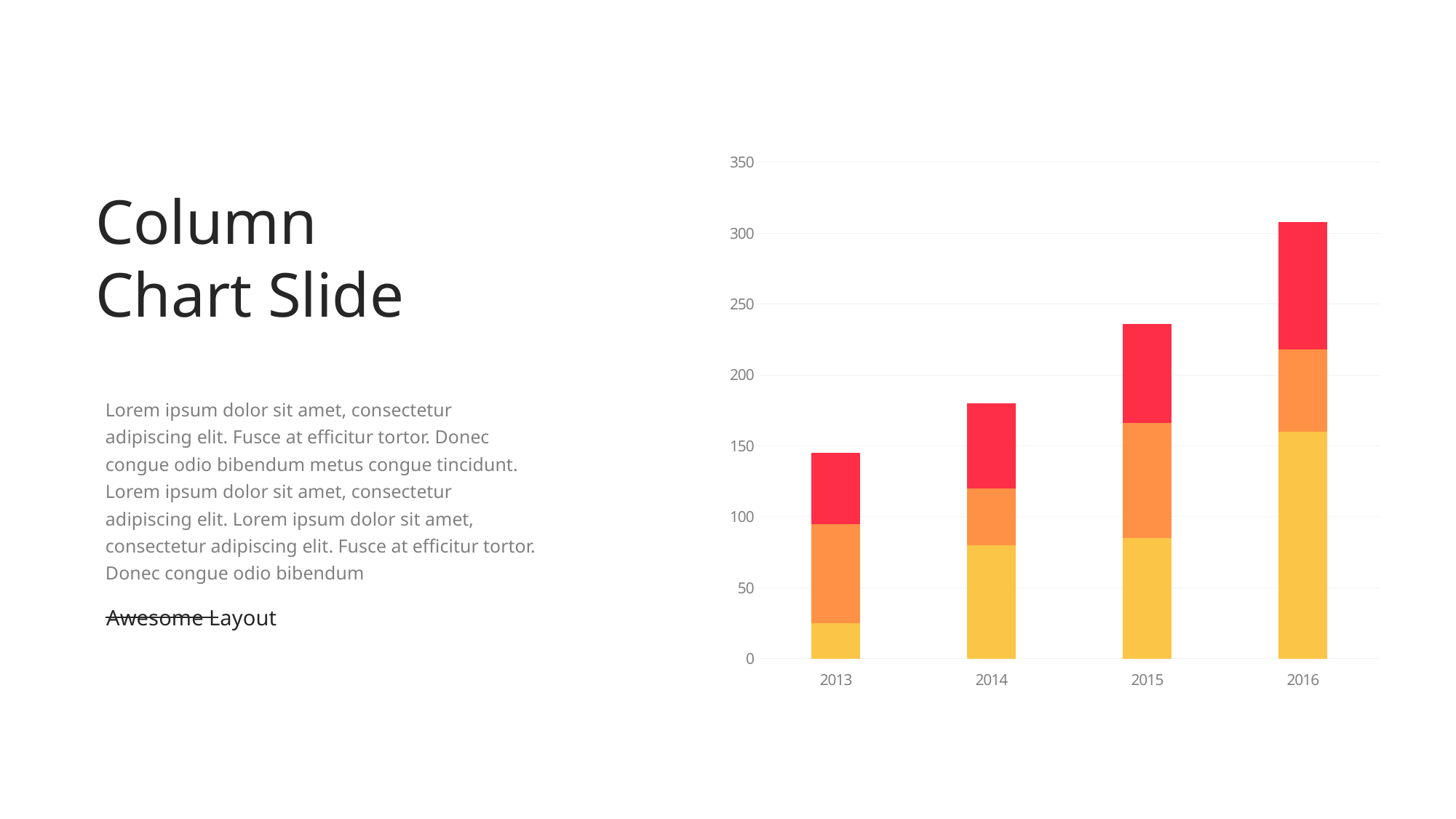
Which year has the tallest stacked bar? 2016 Which year has the shortest stacked bar? 2013 Do the total bar heights rise or fall from 2013 to 2016? rise How many years are shown on the x axis of the chart? 4 Is the total bar height for 2014 greater or less than 150? greater Which year has a taller stacked bar, 2014 or 2015? 2015 Is the total bar height for 2013 greater or less than 100? greater How many coloured segments make up each stacked bar? 3 Is the total bar height for 2016 greater or less than 300? greater What kind of chart is shown on the slide? stacked bar chart